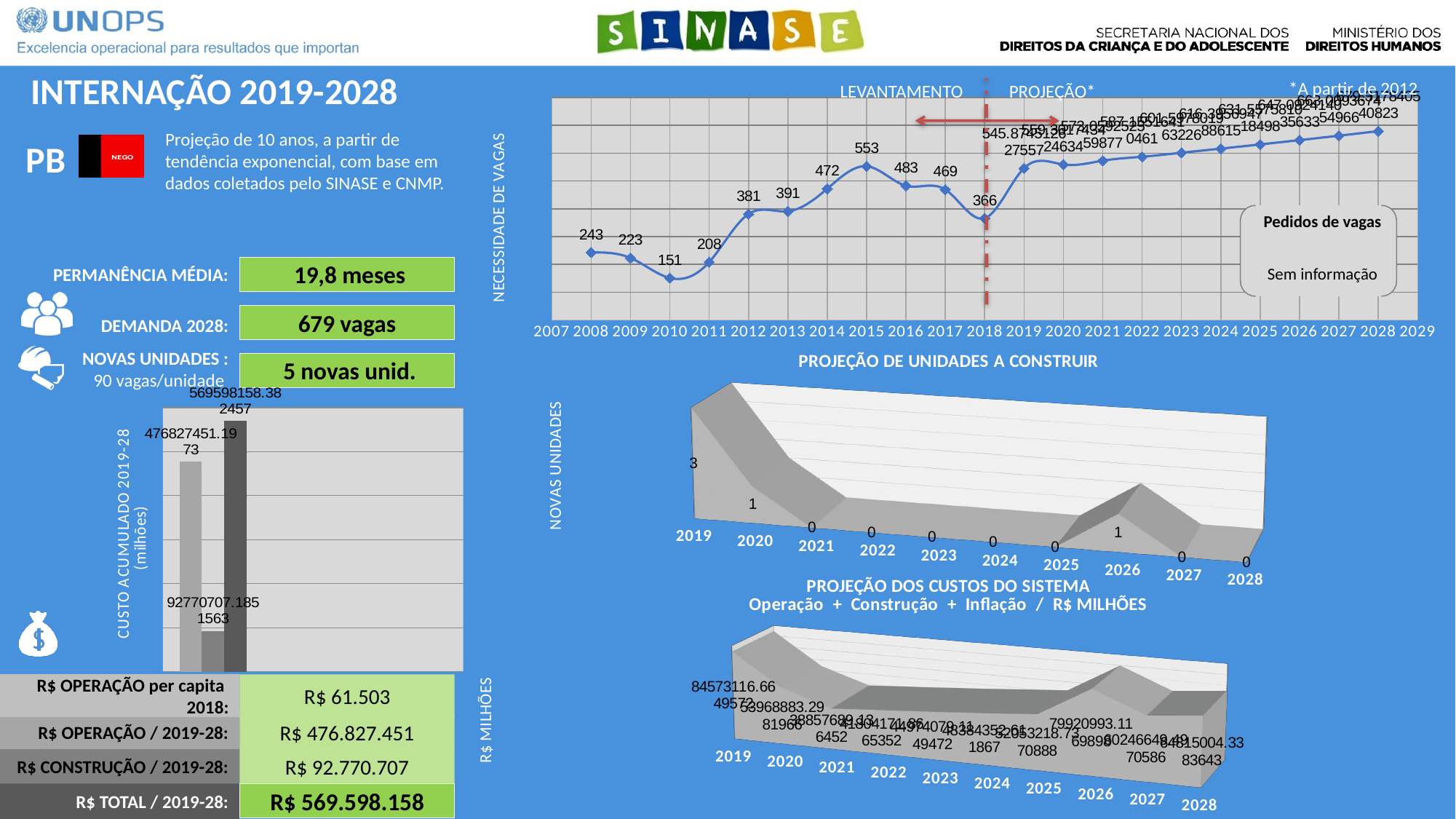
In the NECESSIDADE DE VAGAS line chart, which year has the larger value, 2012 or 2013? 2013 What kind of chart is the NECESSIDADE DE VAGAS chart at the top right? Line chart In the NECESSIDADE DE VAGAS line chart, among the years 2008 to 2018, which year has the highest value? 2015 In the NECESSIDADE DE VAGAS line chart, what is the difference between the values for 2015 and 2018? 187 In the PROJEÇÃO DE UNIDADES A CONSTRUIR chart, how many years are shown on the x axis? 10 In the NECESSIDADE DE VAGAS line chart, do the values rise or fall from 2018 to 2028? Rise In the NECESSIDADE DE VAGAS line chart, what is the value for 2010? 151 In the PROJEÇÃO DE UNIDADES A CONSTRUIR chart, what is the value for 2019? 3 In the NECESSIDADE DE VAGAS line chart, which year has the lowest value? 2010 In the NECESSIDADE DE VAGAS line chart, what is the value for 2018? 366 In the NECESSIDADE DE VAGAS line chart, what label appears to the left of the dashed vertical line? LEVANTAMENTO In the NECESSIDADE DE VAGAS line chart, what is the value for 2015? 553